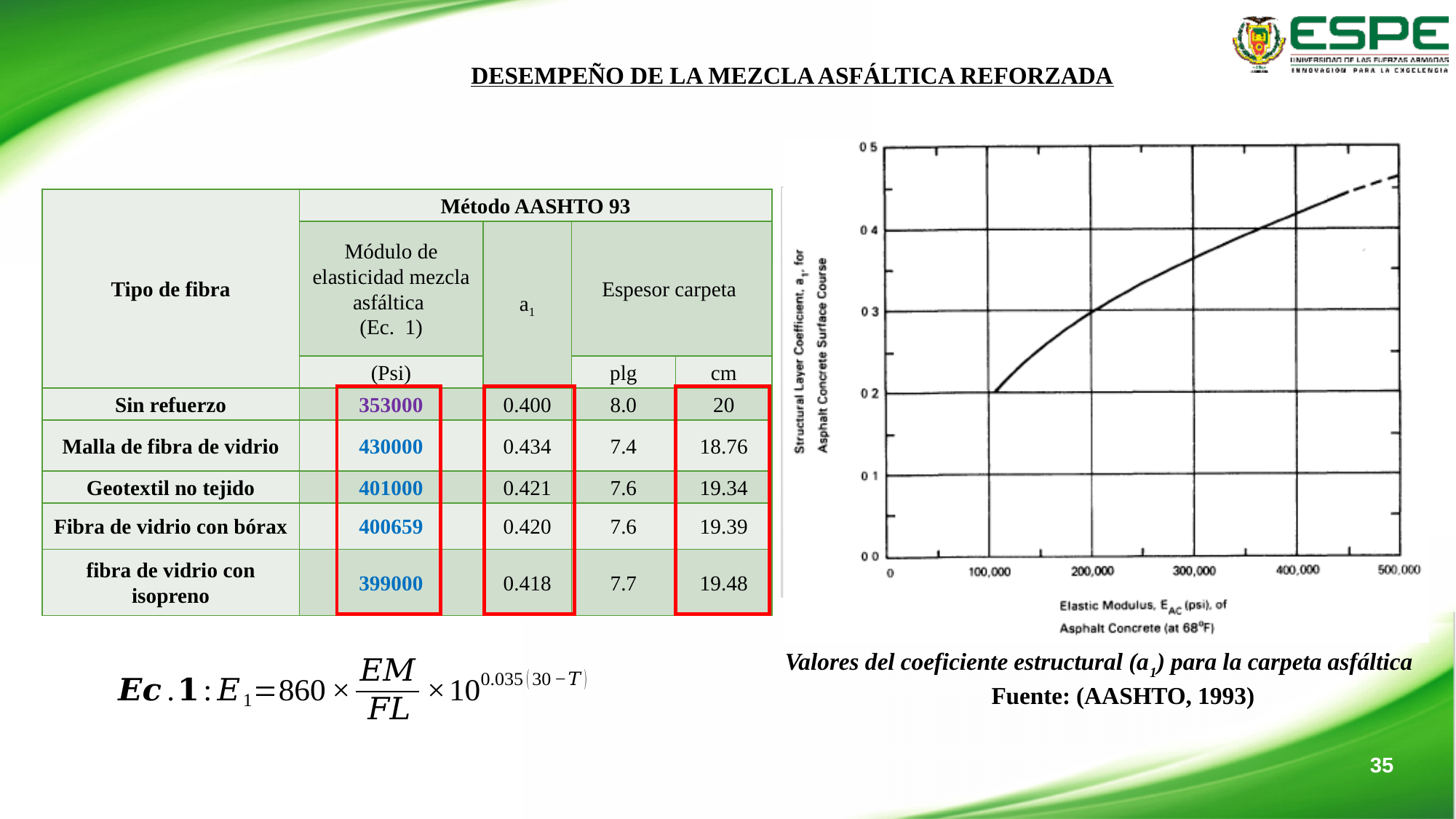
In the chart on the right, does the structural layer coefficient a1 rise or fall as the elastic modulus increases? rise In the chart on the right, is the structural layer coefficient at an elastic modulus of 300,000 psi greater or less than 0.3? greater What quantity is plotted on the x axis of the chart on the right? Elastic Modulus, EAC (psi), of Asphalt Concrete (at 68°F) In the chart on the right, is the structural layer coefficient at an elastic modulus of 300,000 psi greater or less than 0.4? less In the chart on the right, is the structural layer coefficient at an elastic modulus of 150,000 psi greater or less than 0.3? less What is the highest value shown on the x axis of the chart on the right? 500,000 How many curves (series) are plotted in the chart on the right? 1 What kind of chart is shown on the right side of the slide? line chart